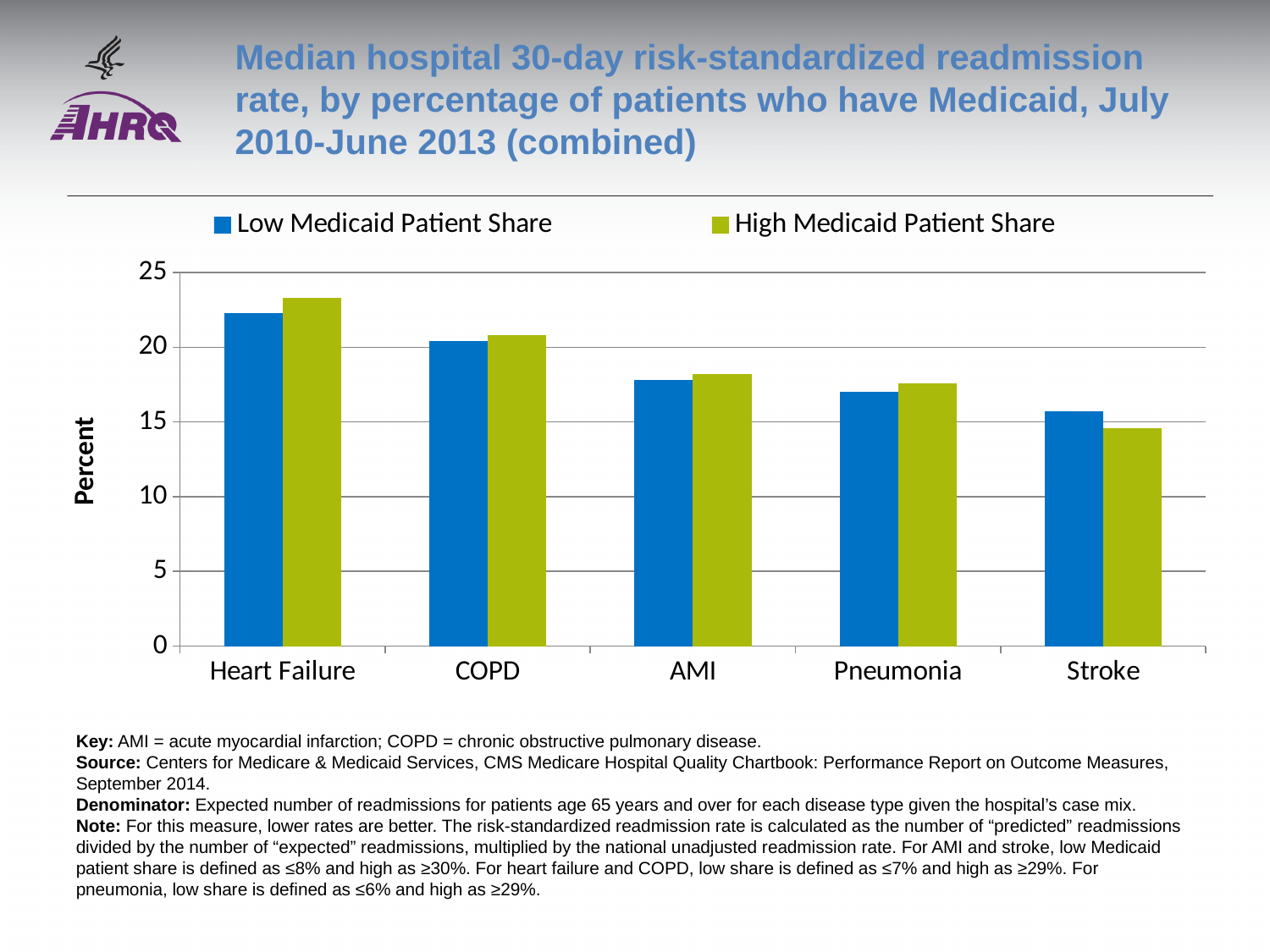
For Stroke, which is larger: Low Medicaid Patient Share or High Medicaid Patient Share? Low Medicaid Patient Share How many series does the legend list? 2 How many disease categories are shown on the x axis? 5 For Heart Failure, which is larger: Low Medicaid Patient Share or High Medicaid Patient Share? High Medicaid Patient Share Which category has the highest readmission rate for Low Medicaid Patient Share? Heart Failure Do the Low Medicaid Patient Share values rise or fall moving from Heart Failure to Stroke along the x axis? Fall What is the label on the y axis? Percent Is the value for Stroke, High Medicaid Patient Share, greater or less than 15? less Is the value for Heart Failure, Low Medicaid Patient Share, greater or less than 20? greater Which category has the lowest readmission rate for High Medicaid Patient Share? Stroke What type of chart is shown on the slide? Bar chart Is the value for AMI, Low Medicaid Patient Share, greater or less than 20? less